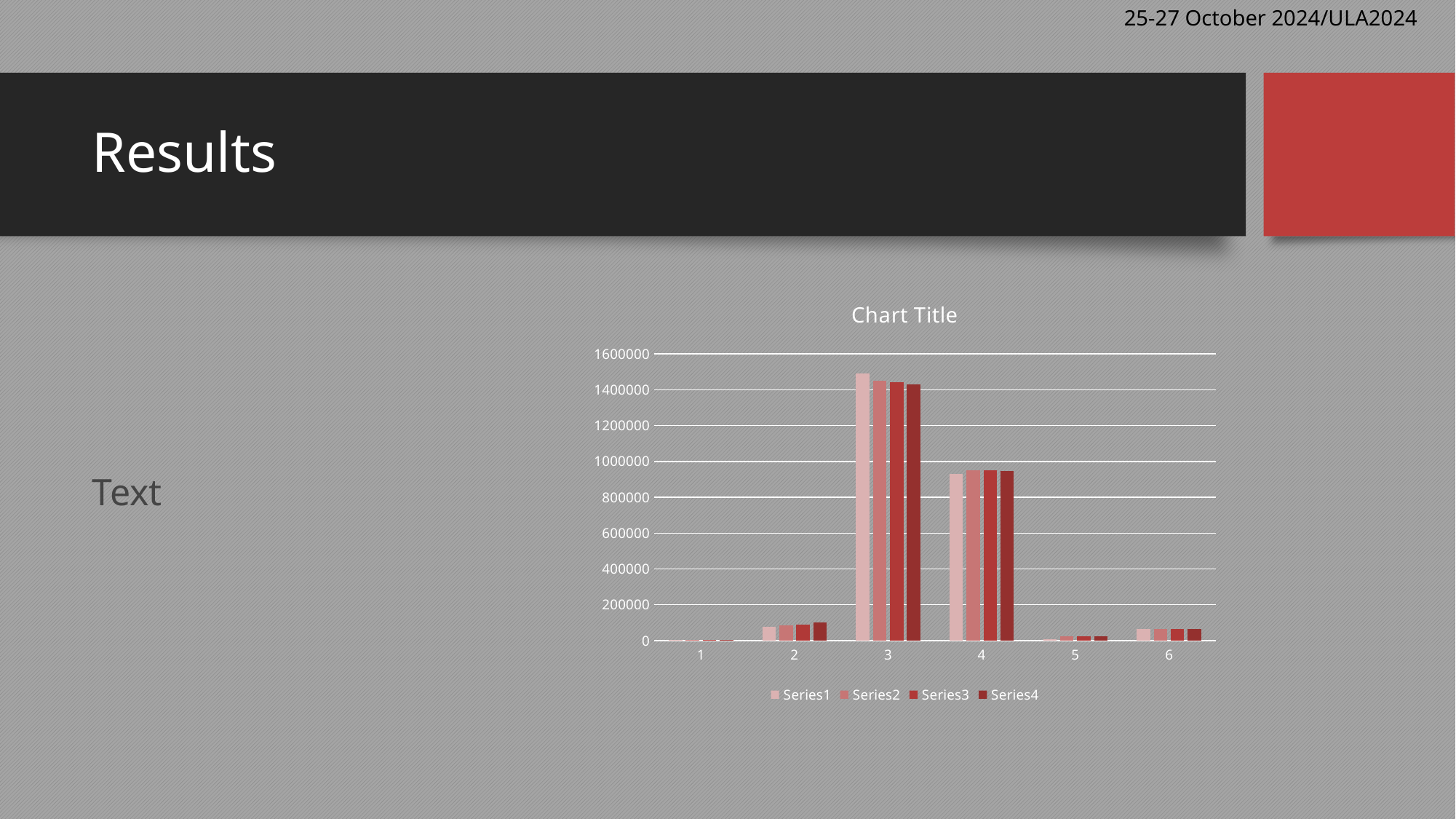
Is the Series2 value for category 4 greater or less than 800000? greater Is the Series1 value for category 4 greater or less than 1000000? less Is the Series1 value for category 3 greater or less than 1400000? greater How many series does the chart legend list? 4 What is the name of the first series listed in the chart legend? Series1 Which category has the lowest values in the chart? 1 Which category has the highest values in the chart? 3 What is the title of the chart? Chart Title How many categories are shown on the x axis of the chart? 6 Which is larger, the Series1 value for category 3 or the Series1 value for category 4? category 3 What kind of chart is shown on the slide? bar chart